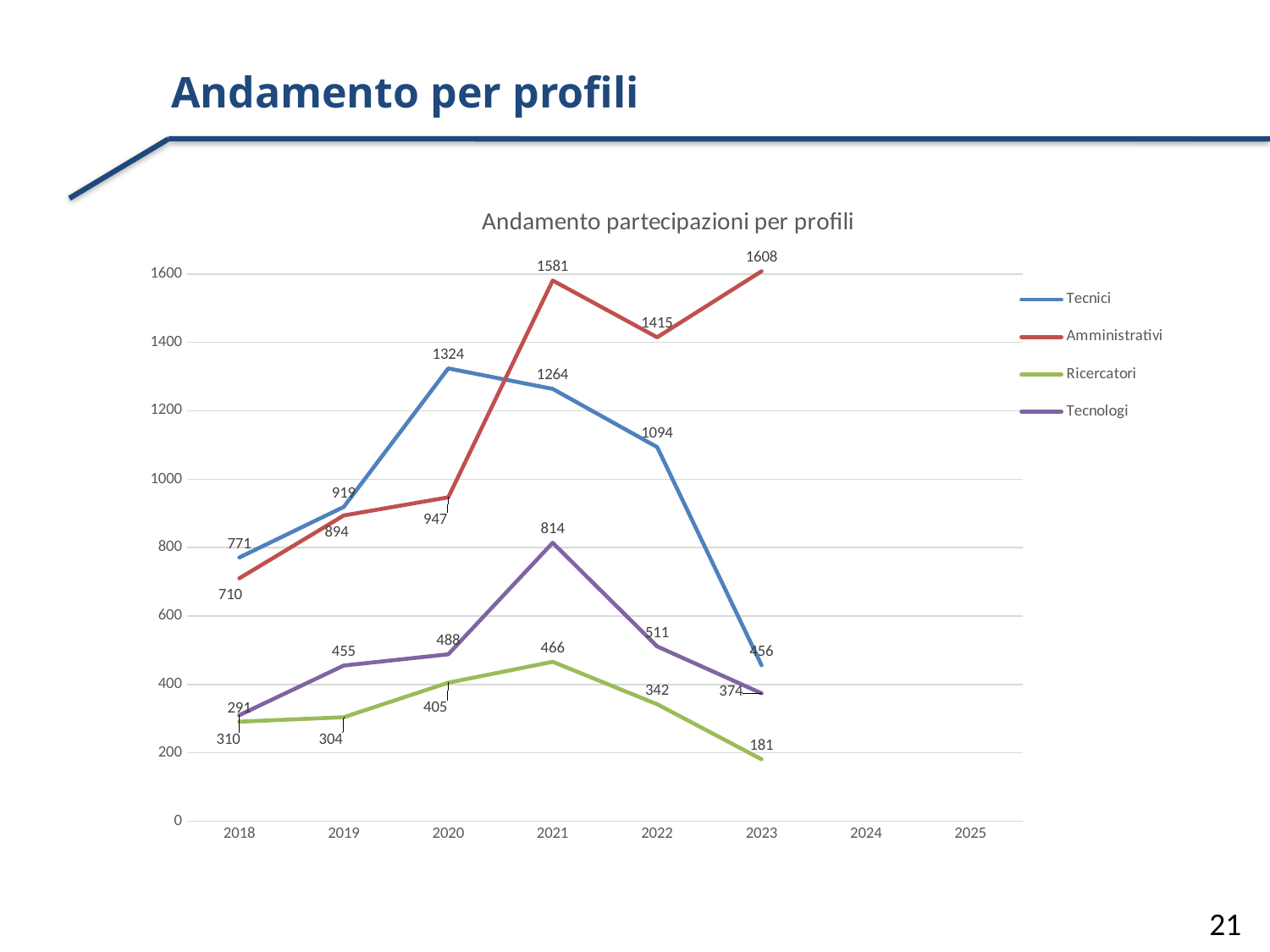
How many years have data points plotted on the chart? 6 In which year does the Amministrativi series reach its highest value? 2023 Do the Tecnici values rise or fall from 2020 to 2023? fall What is the title of the chart? Andamento partecipazioni per profili How many series does the legend list? 4 What kind of chart is shown on the slide? line chart In which year does the Ricercatori series reach its lowest value? 2023 What is the difference between the Tecnici values for 2022 and 2023? 638 What is the value for Tecnici in 2020? 1324 What is the value for Amministrativi in 2021? 1581 In 2021, which is larger: Tecnici or Amministrativi? Amministrativi What is the value for Tecnologi in 2021? 814